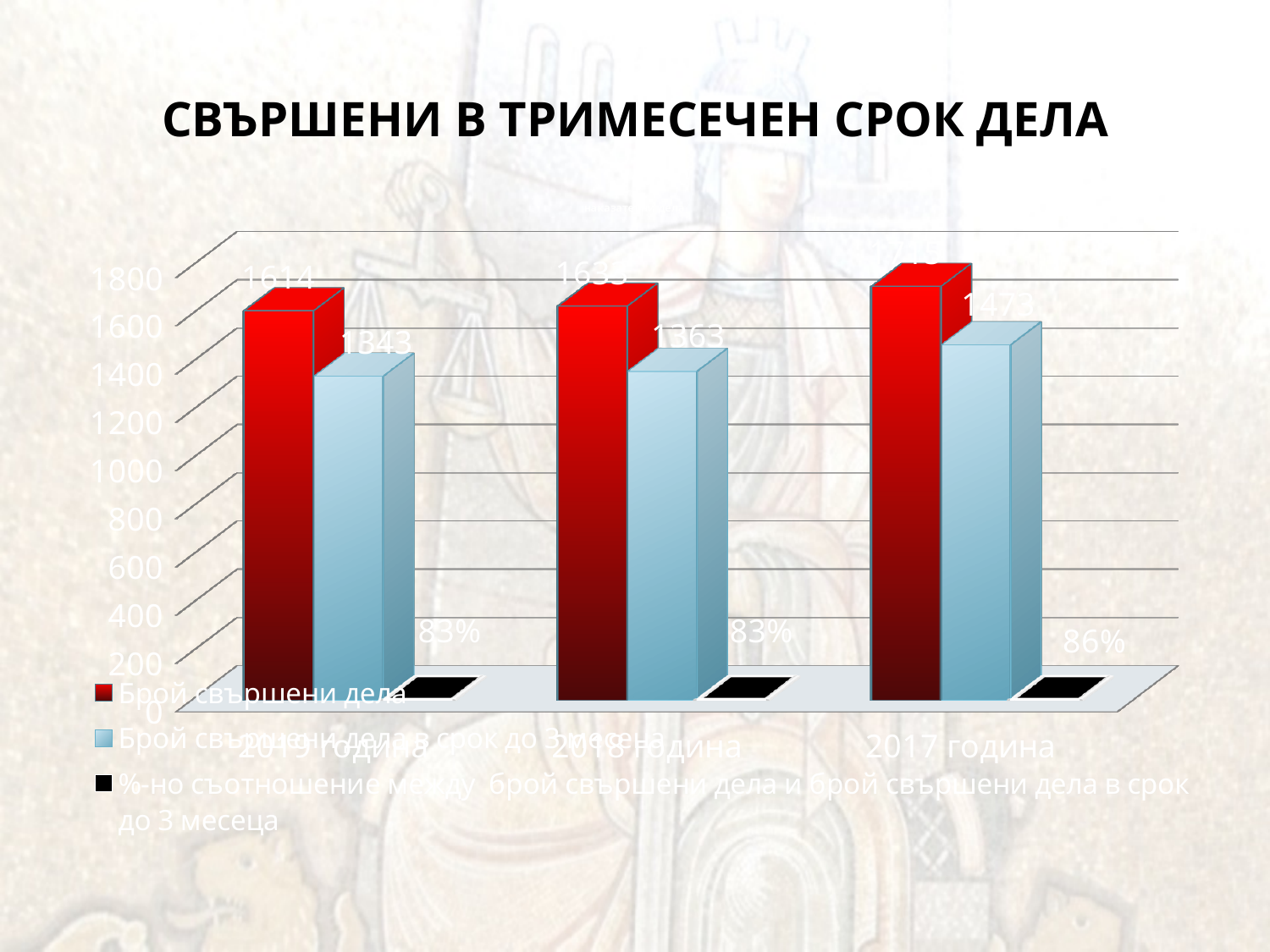
What is the value of Брой свършени дела в срок до 3 месеца for 2017 година? 1473 Which year has the lowest value for Брой свършени дела в срок до 3 месеца? 2019 година What is the difference between Брой свършени дела and Брой свършени дела в срок до 3 месеца for 2019 година? 271 What percentage is shown for 2017 година? 86% How many series does the legend list? 3 How many years are shown on the x axis? 3 What is the value of Брой свършени дела в срок до 3 месеца for 2018 година? 1363 What percentage is shown for 2019 година? 83% Which year has the highest value for Брой свършени дела в срок до 3 месеца? 2017 година What is the value of Брой свършени дела for 2019 година? 1614 Which is larger, Брой свършени дела for 2018 година or for 2019 година? 2018 година What type of chart is shown on the slide? Bar chart